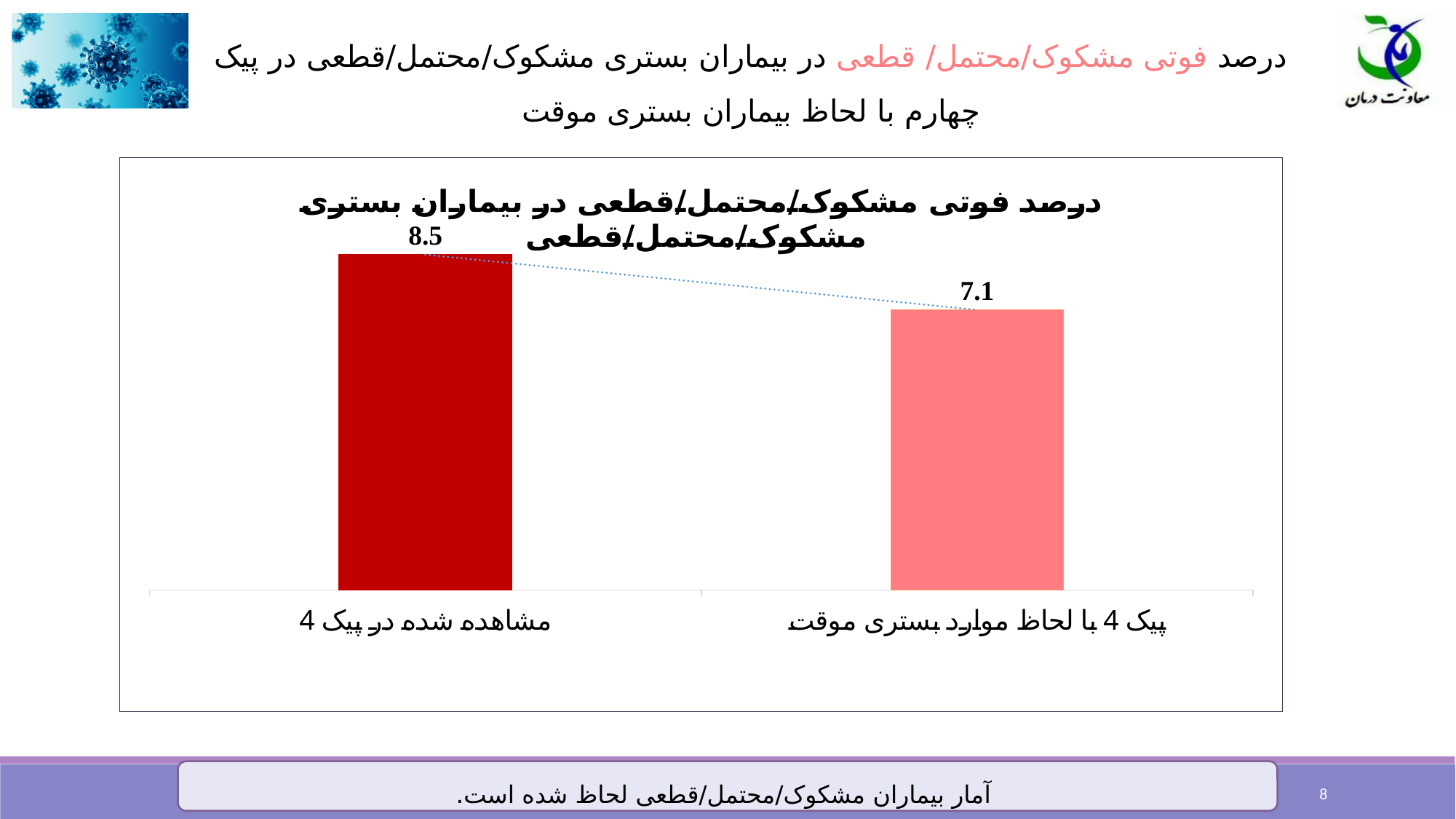
How many categories are shown in the chart? 2 Which is larger: the value for "مشاهده شده در پیک 4" or the value for "پیک 4 با لحاظ موارد بستری موقت"? مشاهده شده در پیک 4 What kind of chart is shown on the slide? Bar chart Which category has the lowest value? پیک 4 با لحاظ موارد بستری موقت What is the value for "پیک 4 با لحاظ موارد بستری موقت"? 7.1 Which category has the highest value? مشاهده شده در پیک 4 Do the values rise or fall from the left bar to the right bar? Fall What is the difference between the value for "مشاهده شده در پیک 4" and the value for "پیک 4 با لحاظ موارد بستری موقت"? 1.4 What is the title of the chart? درصد فوتی مشکوک/محتمل/قطعی در بیماران بستری مشکوک/محتمل/قطعی What colour is the bar for "مشاهده شده در پیک 4"? Dark red What is the value for "مشاهده شده در پیک 4"? 8.5